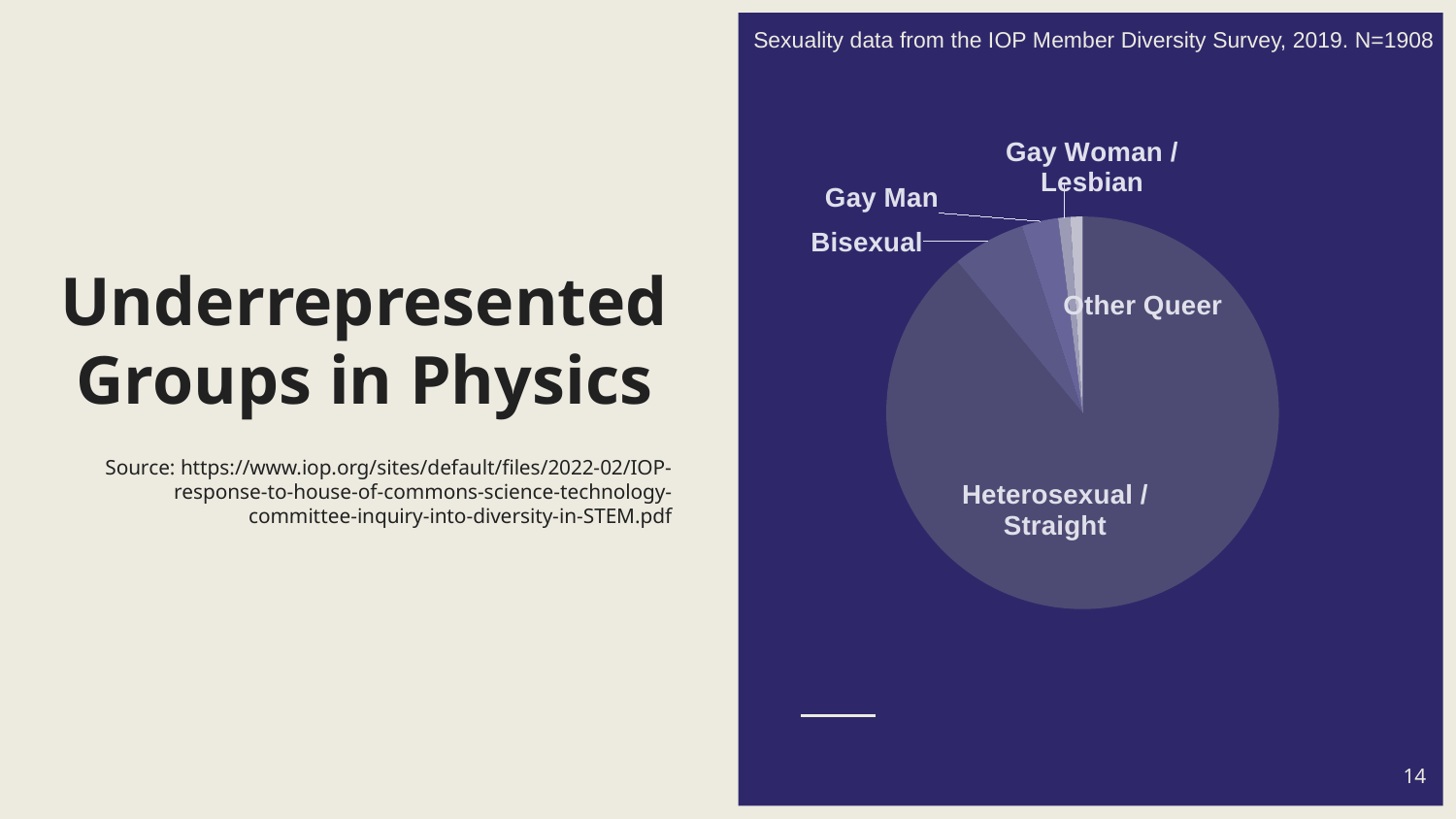
Which slice is larger, Heterosexual / Straight or Bisexual? Heterosexual / Straight What kind of chart is shown on the slide? Pie chart Which category has the largest slice of the pie chart? Heterosexual / Straight Which slice is larger, Bisexual or Gay Man? Bisexual What is the title of the chart? Sexuality data from the IOP Member Diversity Survey, 2019. N=1908 What sample size (N) is stated in the chart title? N=1908 How many categories (slices) does the pie chart show? 5 Which slice is larger, Bisexual or Other Queer? Bisexual